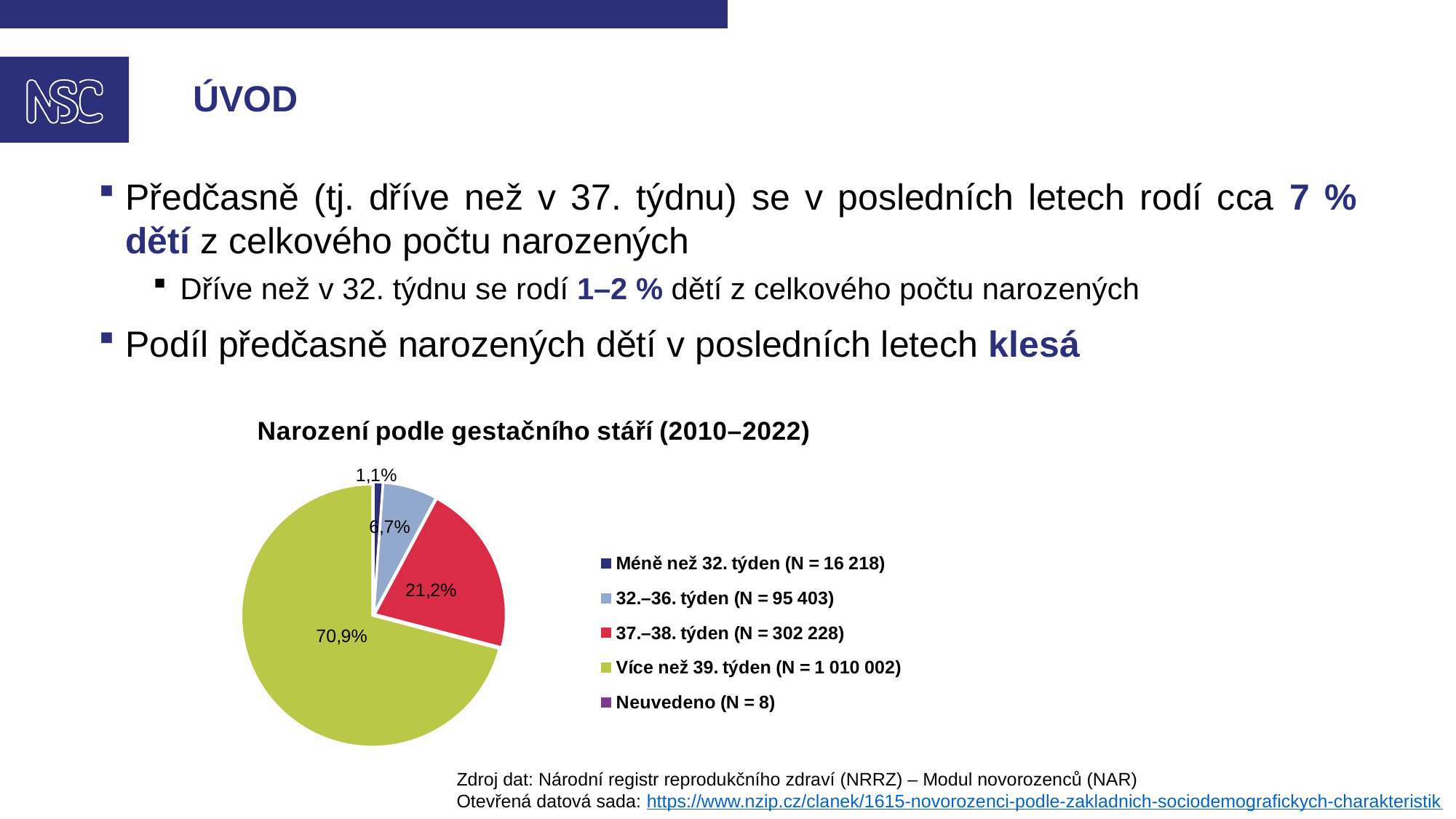
What share of the pie is labelled for the category '32.–36. týden'? 6,7% Which of the two categories has a larger share: '37.–38. týden' or '32.–36. týden'? 37.–38. týden According to the legend, what is the N value for the category 'Neuvedeno'? 8 What type of chart is shown on the slide? pie chart What is the difference in percentage points between the shares of 'Více než 39. týden' and '37.–38. týden'? 49,7 How many entries does the chart's legend list? 5 What share of the pie is labelled for the category '37.–38. týden'? 21,2% According to the legend, what is the N value for the category 'Méně než 32. týden'? 16 218 What share of the pie is labelled for the category 'Méně než 32. týden'? 1,1% Which category has the largest slice of the pie? Více než 39. týden What is the title of the chart? Narození podle gestačního stáří (2010–2022)